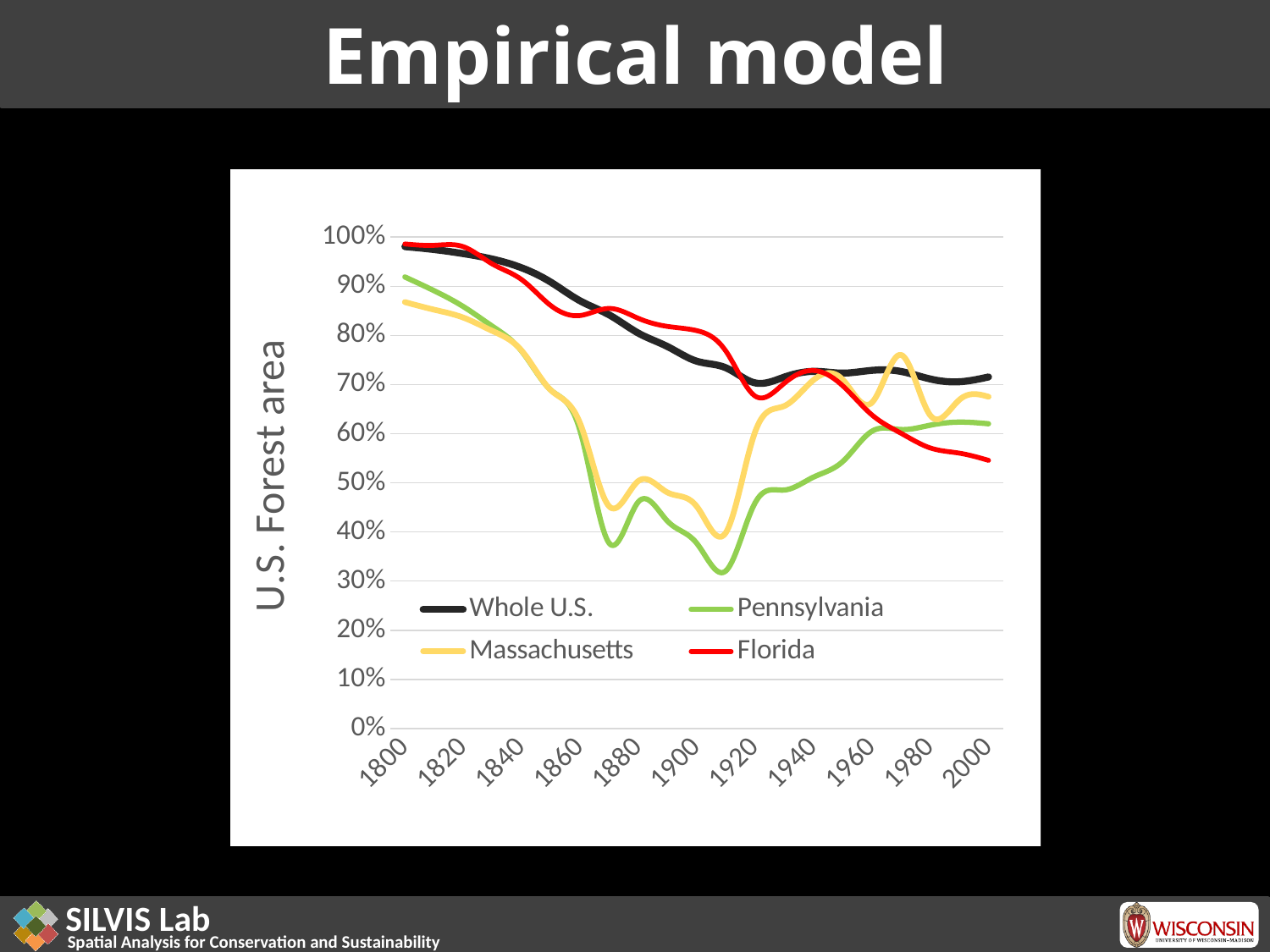
Is the value for Massachusetts in 1800 greater or less than 90%? less What kind of chart is shown on the slide? line chart Does the Pennsylvania line rise or fall from 1920 to 2000? rise How many series does the legend list? 4 Which series has the lowest value in 2000? Florida Which series has the lowest value in 1800? Massachusetts In 2000, which is larger: the value for Whole U.S. or the value for Florida? Whole U.S. Is the value for Florida in 2000 greater or less than 60%? less What colour is the Florida line? red Does the Whole U.S. line rise or fall from 1800 to 2000? fall What is the title of the vertical axis? U.S. Forest area Is the lowest value reached by the Pennsylvania line greater or less than 40%? less